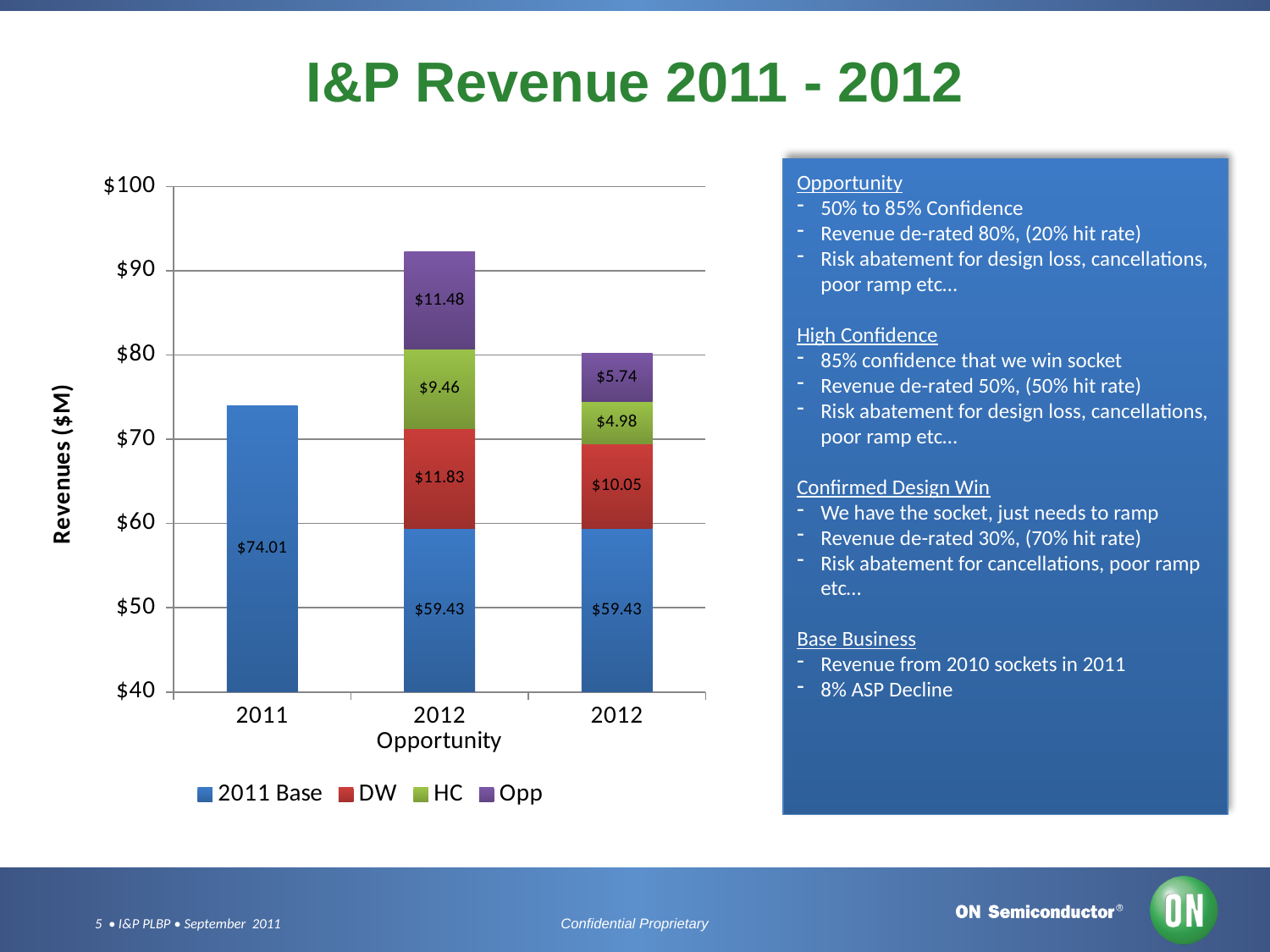
What is the Opp value for the 2012 bar? $5.74 What is the HC value for the 2012 Opportunity bar? $9.46 What is the total of the 2012 Opportunity stacked bar? $92.20 How many bars are plotted on the chart? 3 What is the title of the y axis? Revenues ($M) What is the total of the 2012 stacked bar? $80.20 What is the 2011 Base value for the 2011 bar? $74.01 What type of chart is shown on the slide? Stacked bar chart What is the difference between the Opp value for 2012 Opportunity and the Opp value for 2012? $5.74 How many series does the legend list? 4 What is the DW value for the 2012 Opportunity bar? $11.83 Which is larger, the HC value for 2012 Opportunity or the HC value for 2012? 2012 Opportunity